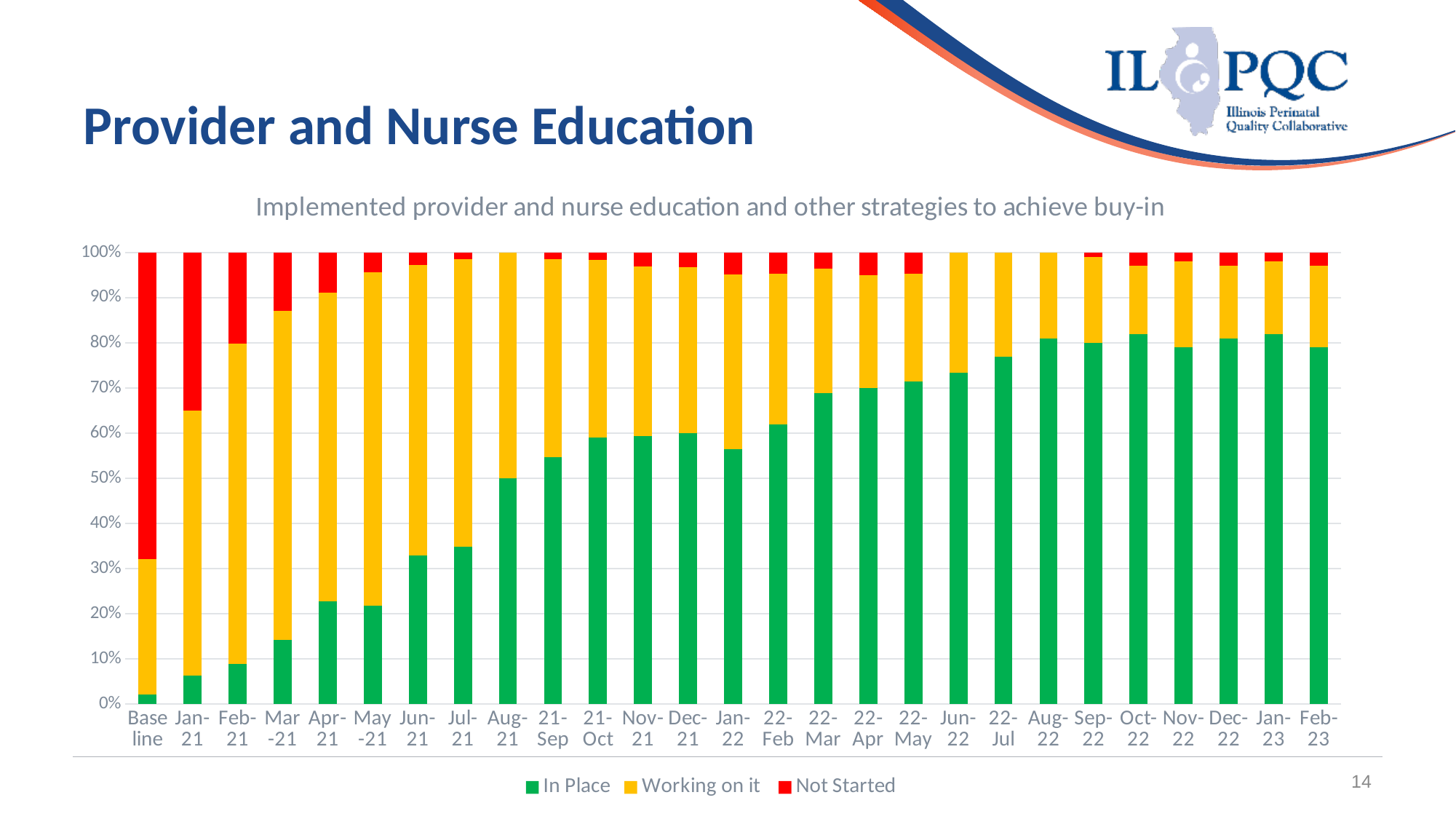
Which has the larger In Place share, Baseline or Feb-23? Feb-23 Which category has the lowest In Place share? Baseline Is the In Place value for 22-Mar greater or less than 60%? greater Does the In Place share generally rise or fall from Baseline to Feb-23? rise How many series does the legend list? 3 How many time-period categories are shown along the x axis? 27 What are the three series named in the legend? In Place, Working on it, Not Started What kind of chart is shown on the slide? stacked bar chart Is the Not Started value for Baseline greater or less than 60%? greater Is the In Place value for Baseline greater or less than 10%? less Which category has the highest Not Started share? Baseline